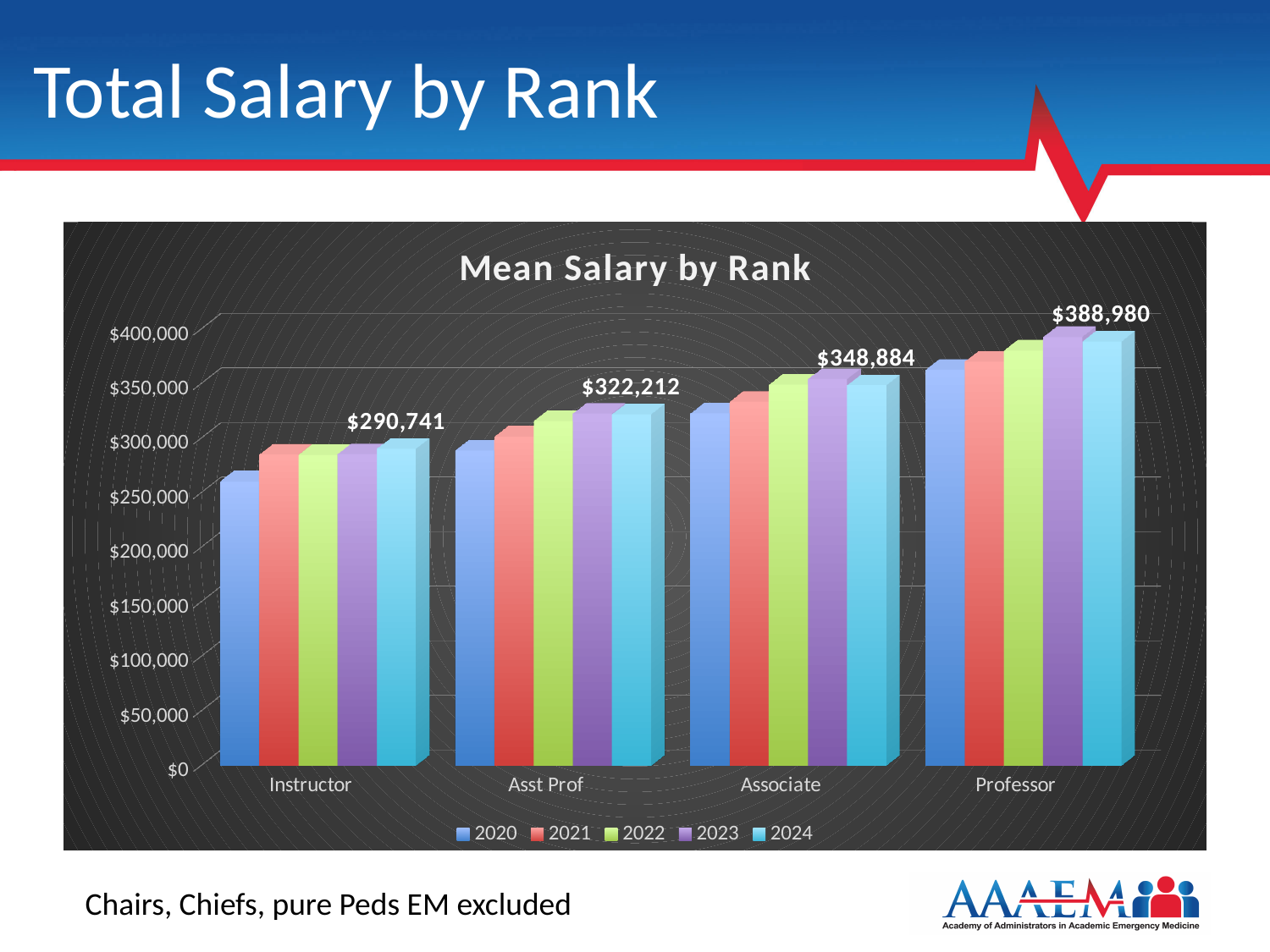
What is the data label shown for Asst Prof? $322,212 What is the data label shown for Professor? $388,980 What is the difference between the labeled values for Professor and Instructor? $98,239 Which rank has the highest labeled mean salary? Professor Do the mean salaries rise or fall moving from Instructor to Professor along the x axis? rise What is the title of the chart? Mean Salary by Rank What is the data label shown for Instructor? $290,741 How many rank categories are shown on the x axis? 4 What is the data label shown for Associate? $348,884 Is the 2020 value for Instructor greater or less than $300,000? less What type of chart is shown on the slide? bar chart How many series does the legend list? 5